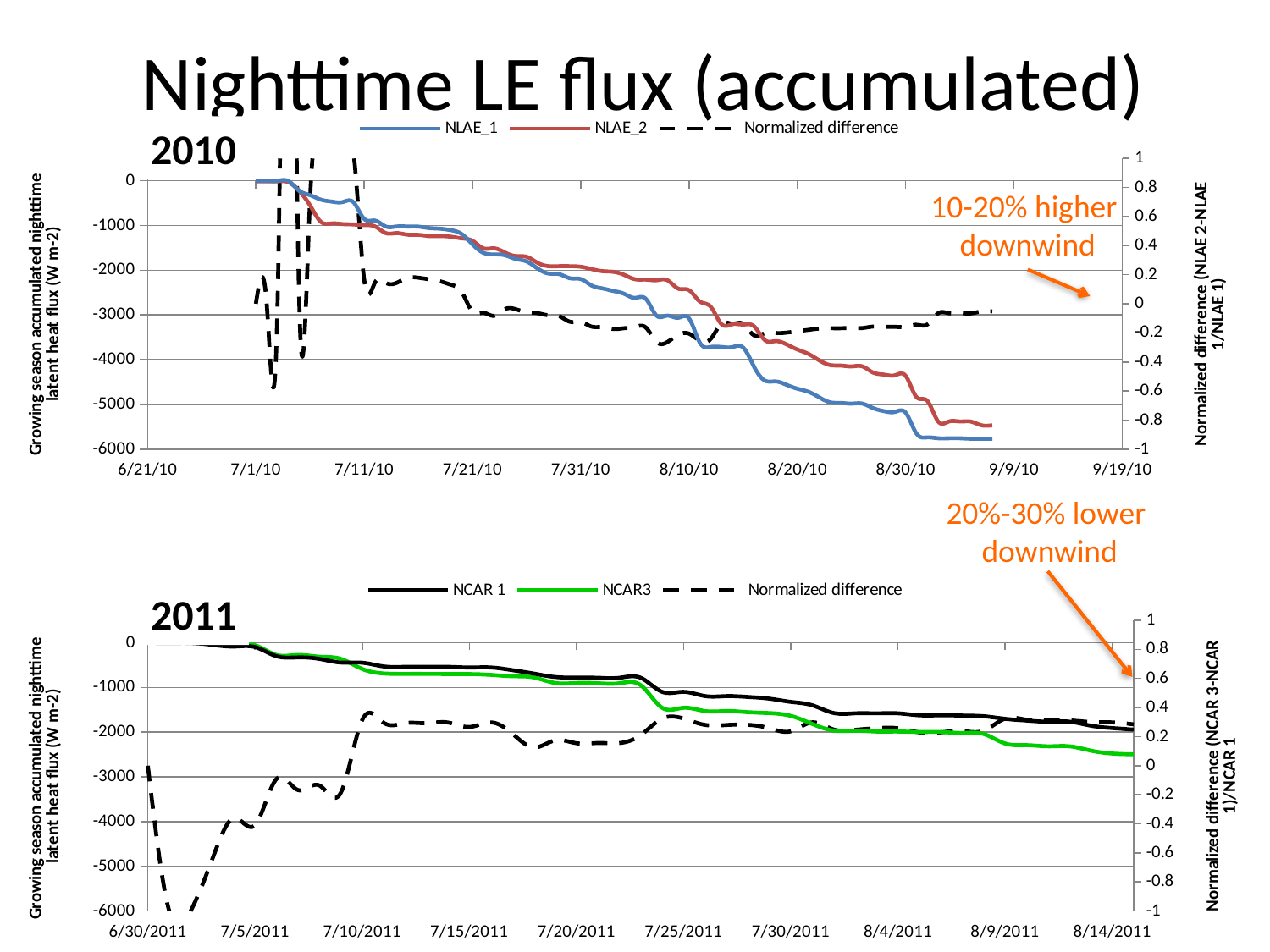
What is the title of the slide containing the two charts? Nighttime LE flux (accumulated) In the 2010 chart, at the end of the series, which is lower (more negative): NLAE_1 or NLAE_2? NLAE_1 In the 2011 chart, does the NCAR3 series rise or fall along the x axis? fall In the 2010 chart, does the NLAE_1 series rise or fall along the x axis? fall In the 2011 chart, at the end of the series, which is lower (more negative): NCAR 1 or NCAR3? NCAR3 In the 2011 chart, at 7/20/2011, is the value for NCAR 1 greater or less than -1000? greater In the 2011 chart, which series is drawn as a dashed line? Normalized difference In the 2011 chart, at the end of the series (around 8/14/2011), is the value for NCAR3 greater or less than -2000? less How many series does the legend of the 2011 chart list? 3 How many series does the legend of the 2010 chart list? 3 In the 2010 chart, at the end of the series (around 9/9/10), is the value for NLAE_1 greater or less than -5000? less What kind of chart is the 2010 chart at the top of the slide? line chart